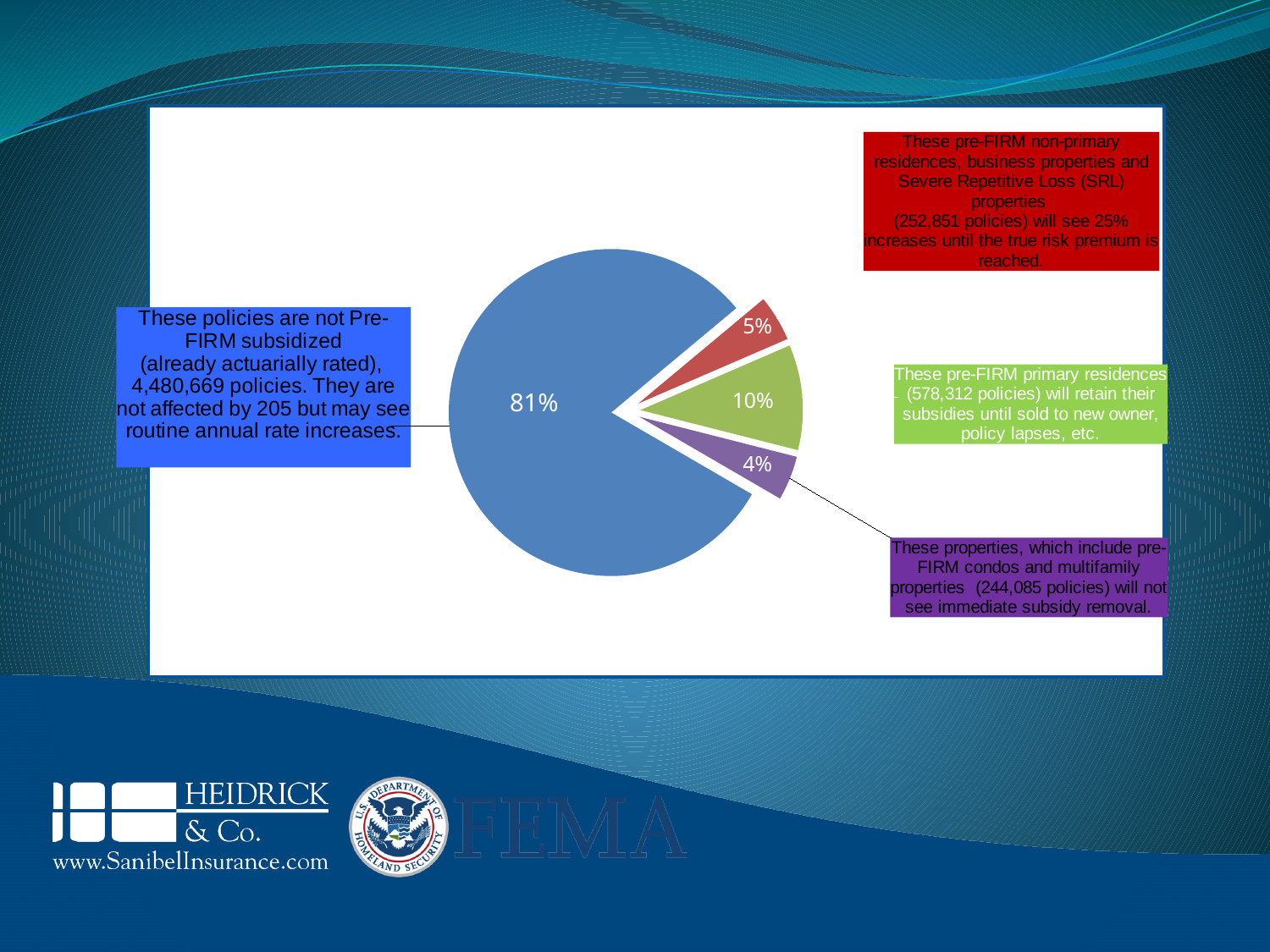
Which is larger in the pie chart, the red slice or the purple slice? the red slice What colour is the slice labelled 10% in the pie chart? green How many slices does the pie chart have? 4 What percentage is shown for the green slice of the pie chart (pre-FIRM primary residences)? 10% What percentage is shown for the blue slice of the pie chart (policies not Pre-FIRM subsidized)? 81% What percentage is shown for the red slice of the pie chart (pre-FIRM non-primary residences, business and SRL properties)? 5% Which slice of the pie chart is the largest? the blue slice, 81% What kind of chart is shown on the slide? pie chart By how many percentage points does the green slice (10%) exceed the red slice (5%)? 5 percentage points Which slice of the pie chart is the smallest? the purple slice, 4% According to the blue callout box, how many policies are not Pre-FIRM subsidized? 4,480,669 policies What percentage is shown for the purple slice of the pie chart (pre-FIRM condos and multifamily properties)? 4%